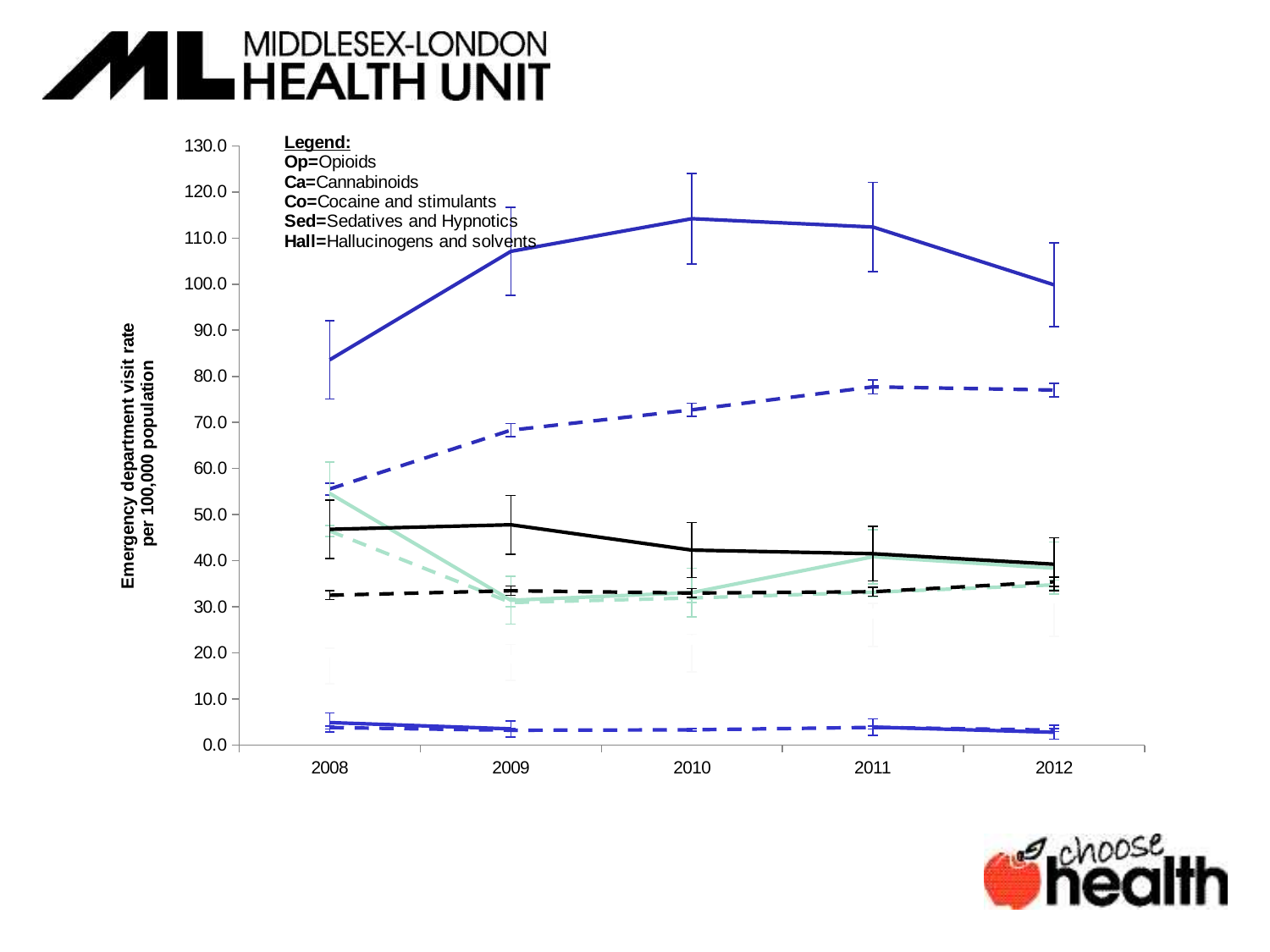
What kind of chart is shown on the slide? line chart What is the label of the y axis of the chart? Emergency department visit rate per 100,000 population How many years are shown along the x axis of the chart? 5 Is the value of the highest (solid blue) line in 2010 greater or less than 110? greater Does the dashed blue line in the middle of the chart rise or fall from 2008 to 2011? rise In which year is the highest (solid blue) line at its lowest value? 2008 According to the chart's legend, what does "Sed" stand for? Sedatives and Hypnotics How many drug categories does the legend on the chart define? 5 In which year does the highest (solid blue) line reach its peak? 2010 Is the value of the highest (solid blue) line in 2008 greater or less than 90? less Are the values of the two lowest lines on the chart greater or less than 10 in every year? less For the highest (solid blue) line, is the value larger in 2008 or in 2010? 2010